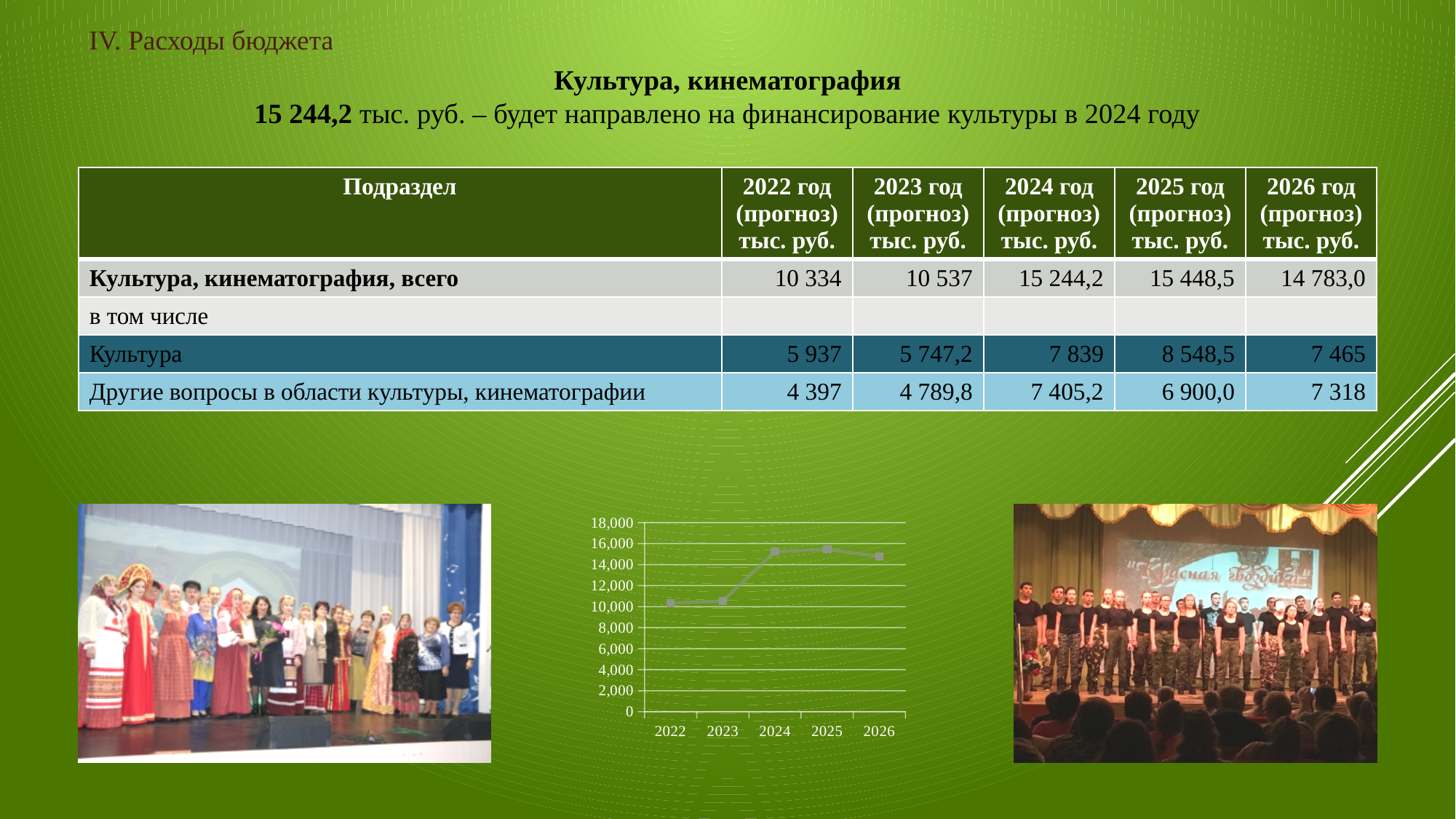
In the line chart, does the value rise or fall between 2023 and 2024? rise In the line chart, is the value for 2024 greater or less than 14,000? greater In the line chart, which year has the larger value, 2022 or 2024? 2024 In the line chart, is the value for 2026 greater or less than 16,000? less In the line chart, is the value for 2025 greater or less than 14,000? greater What kind of chart is shown in the middle of the slide? line chart In the line chart, does the value rise or fall between 2025 and 2026? fall How many years are plotted along the x axis of the line chart? 5 What is the highest value shown on the y axis of the line chart? 18,000 In the line chart, which year has the larger value, 2023 or 2026? 2026